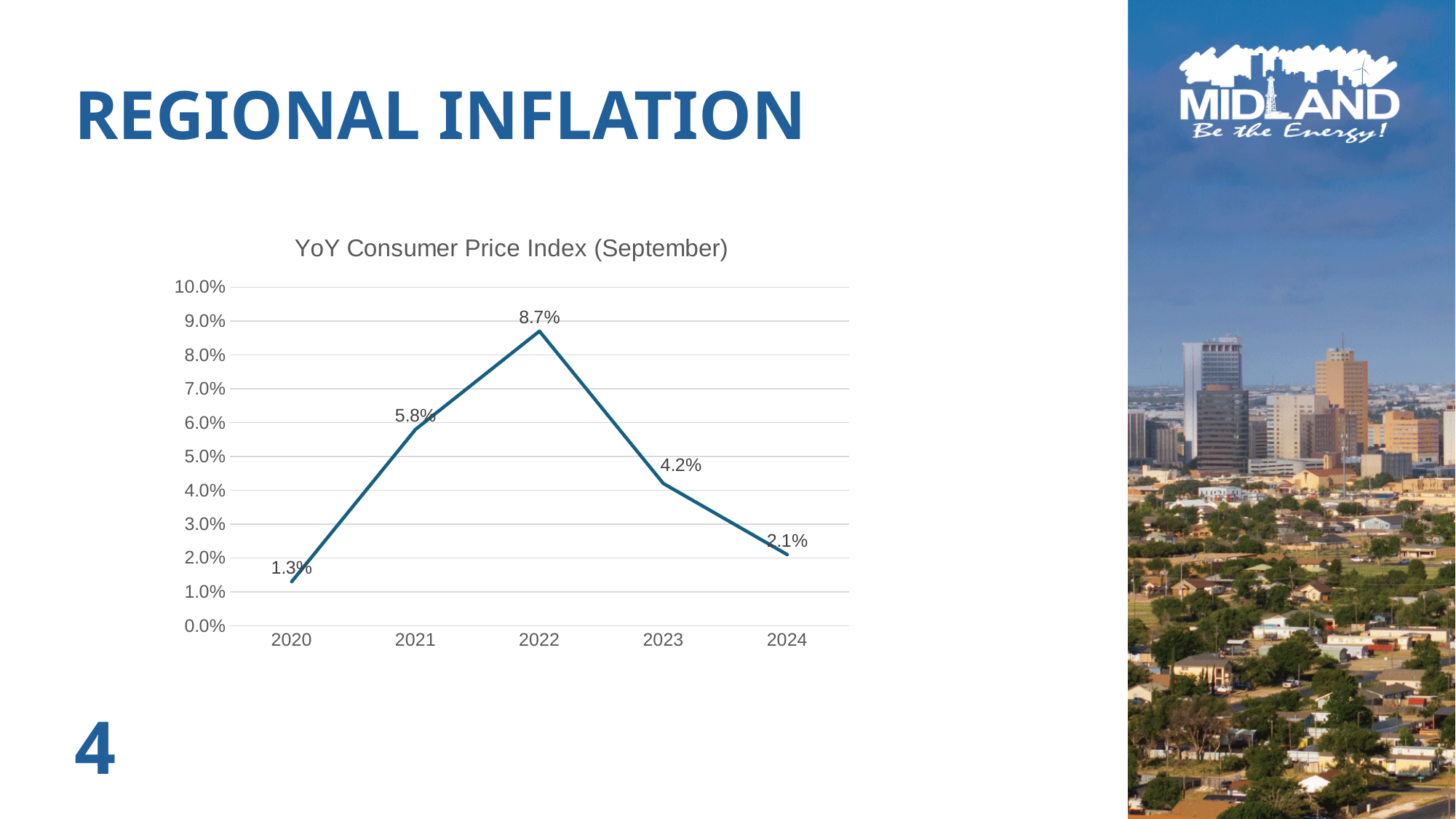
What is the YoY Consumer Price Index value for 2024? 2.1% Does the YoY Consumer Price Index rise or fall from 2022 to 2024? fall What is the title of the chart? YoY Consumer Price Index (September) What kind of chart is shown on the slide? line chart Which year has a higher YoY Consumer Price Index, 2021 or 2023? 2021 Which year has the lowest YoY Consumer Price Index? 2020 How many years are plotted on the chart? 5 What is the YoY Consumer Price Index value for 2020? 1.3% Which year has the highest YoY Consumer Price Index? 2022 What is the YoY Consumer Price Index value for 2022? 8.7% Is the value for 2021 greater or less than 5.0%? greater What is the difference between the 2022 and 2023 YoY Consumer Price Index values? 4.5%